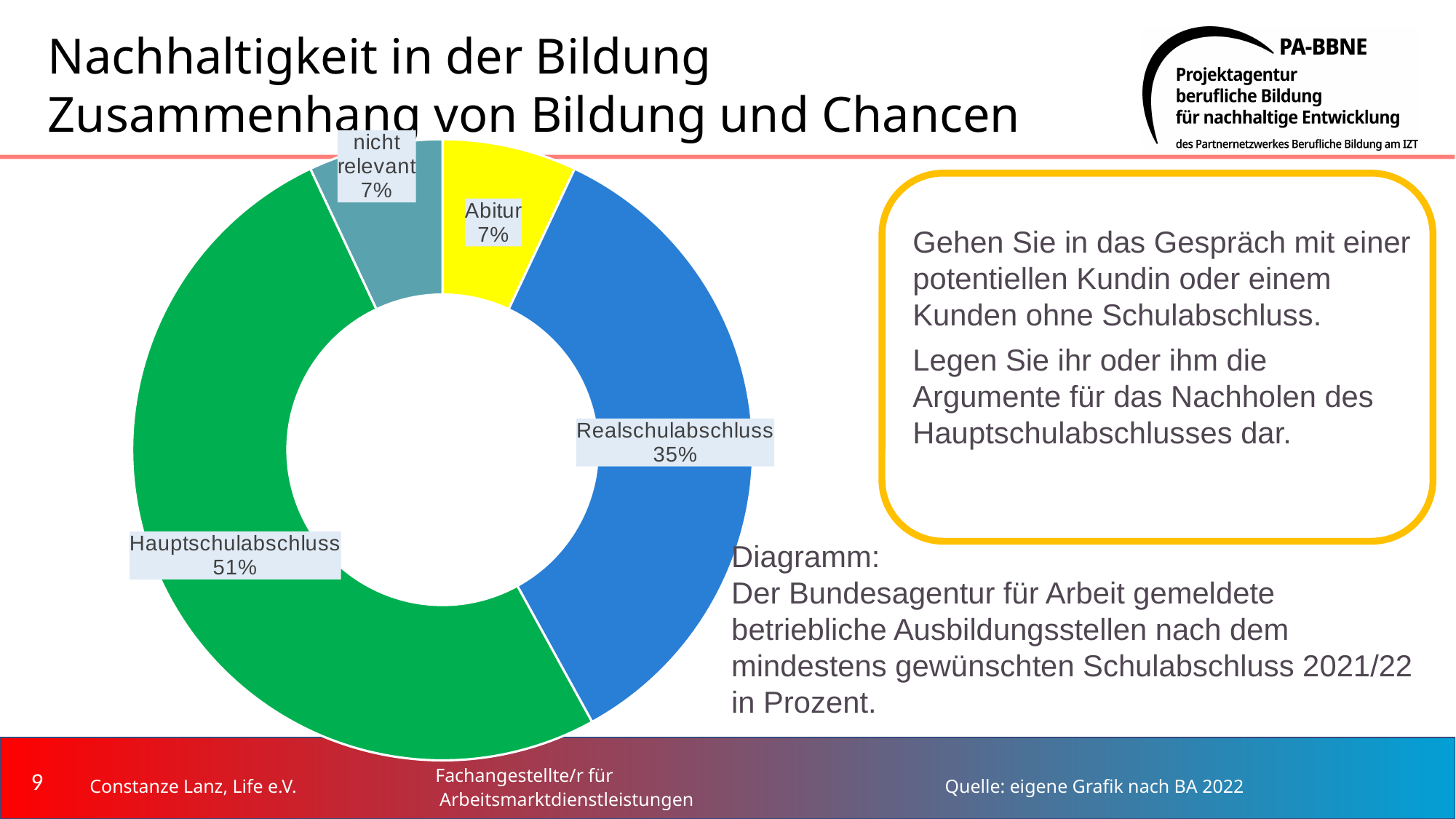
How many slices does the chart have? 4 What share of the doughnut chart is labelled Hauptschulabschluss? 51% What percentage is shown for Abitur in the chart? 7% What colour is the Abitur slice? Yellow What percentage is shown for the slice labelled 'nicht relevant'? 7% What colour is the Realschulabschluss slice? Blue What is the combined share of Abitur and 'nicht relevant'? 14% Which category has the largest slice in the chart? Hauptschulabschluss Which slice is larger, Realschulabschluss or Abitur? Realschulabschluss What is the difference in percentage points between Hauptschulabschluss and Realschulabschluss? 16 What percentage is shown for Realschulabschluss in the chart? 35% What kind of chart is shown on the slide? Doughnut (pie) chart